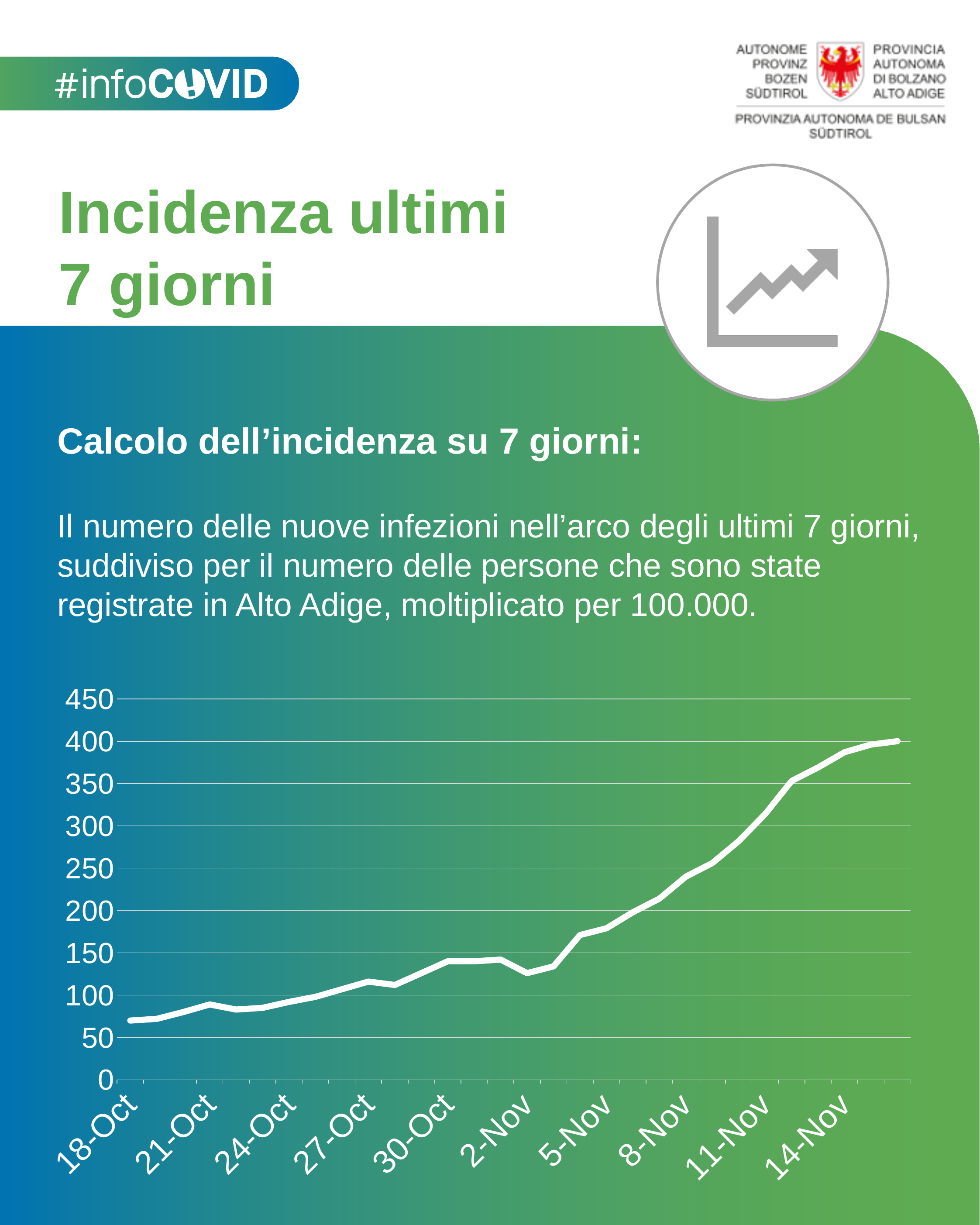
Is the value for 2-Nov greater or less than 150? less What kind of chart is shown on the slide? line chart Is the value for 18-Oct greater or less than 100? less Is the value for 14-Nov greater or less than 350? greater Among the labelled dates, which has the lowest value? 18-Oct Do the values generally rise or fall from 18-Oct to 14-Nov? rise What is the highest value shown on the y axis of the chart? 450 Which has the larger value, 18-Oct or 14-Nov? 14-Nov How many dates are labelled on the x axis of the chart? 10